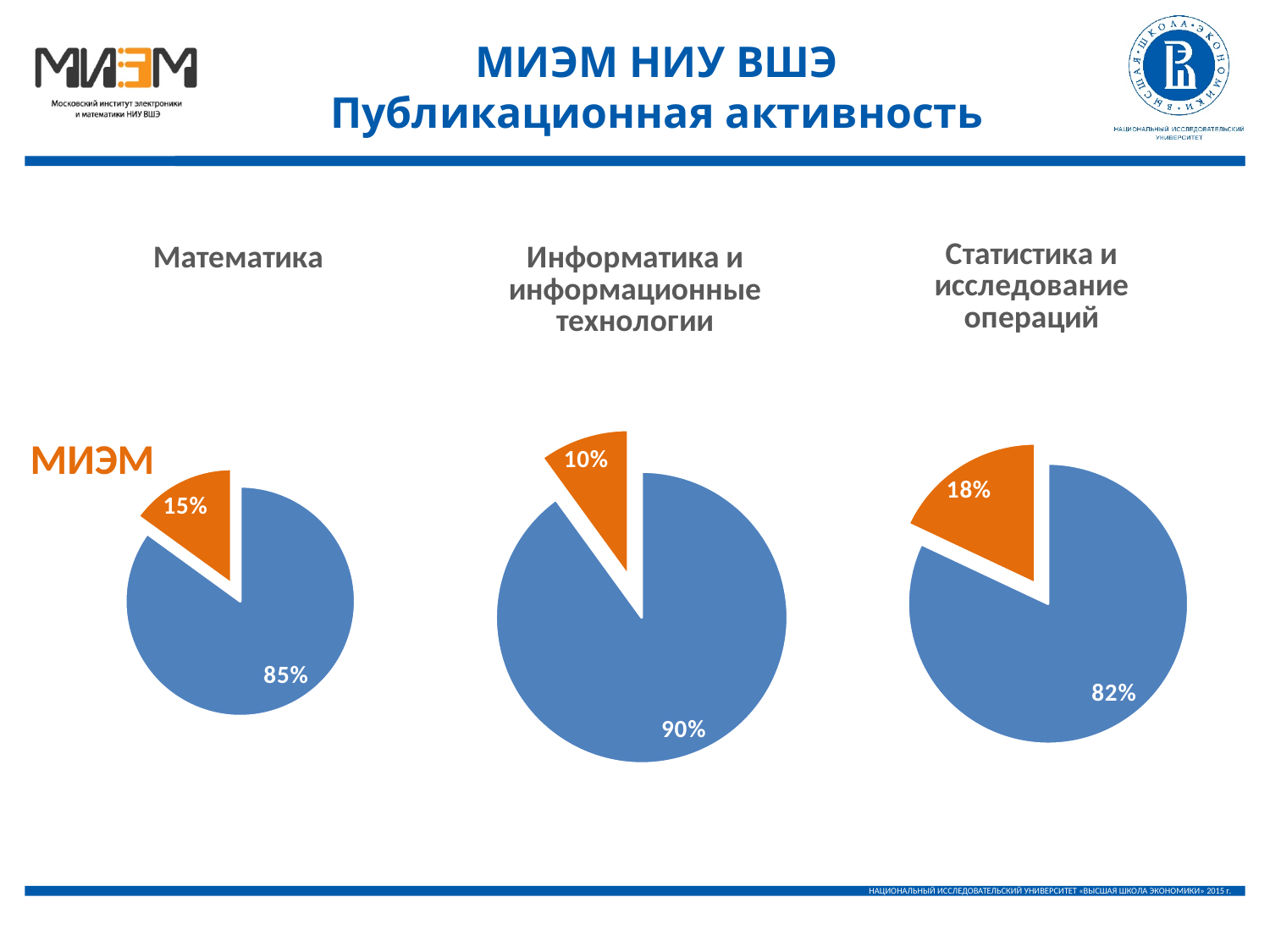
What is the difference between the orange slice in the 'Статистика и исследование операций' chart and the orange slice in the 'Математика' chart? 3% In the 'Статистика и исследование операций' pie chart, what share does the orange slice have? 18% In the 'Информатика и информационные технологии' pie chart, what share does the orange slice have? 10% Which pie chart has the largest orange slice? Статистика и исследование операций Which pie chart has the smallest orange slice? Информатика и информационные технологии In the 'Информатика и информационные технологии' pie chart, what share does the blue slice have? 90% What kind of charts are shown on the slide? Pie charts How many slices does each pie chart have? 2 How many pie charts are on the slide? 3